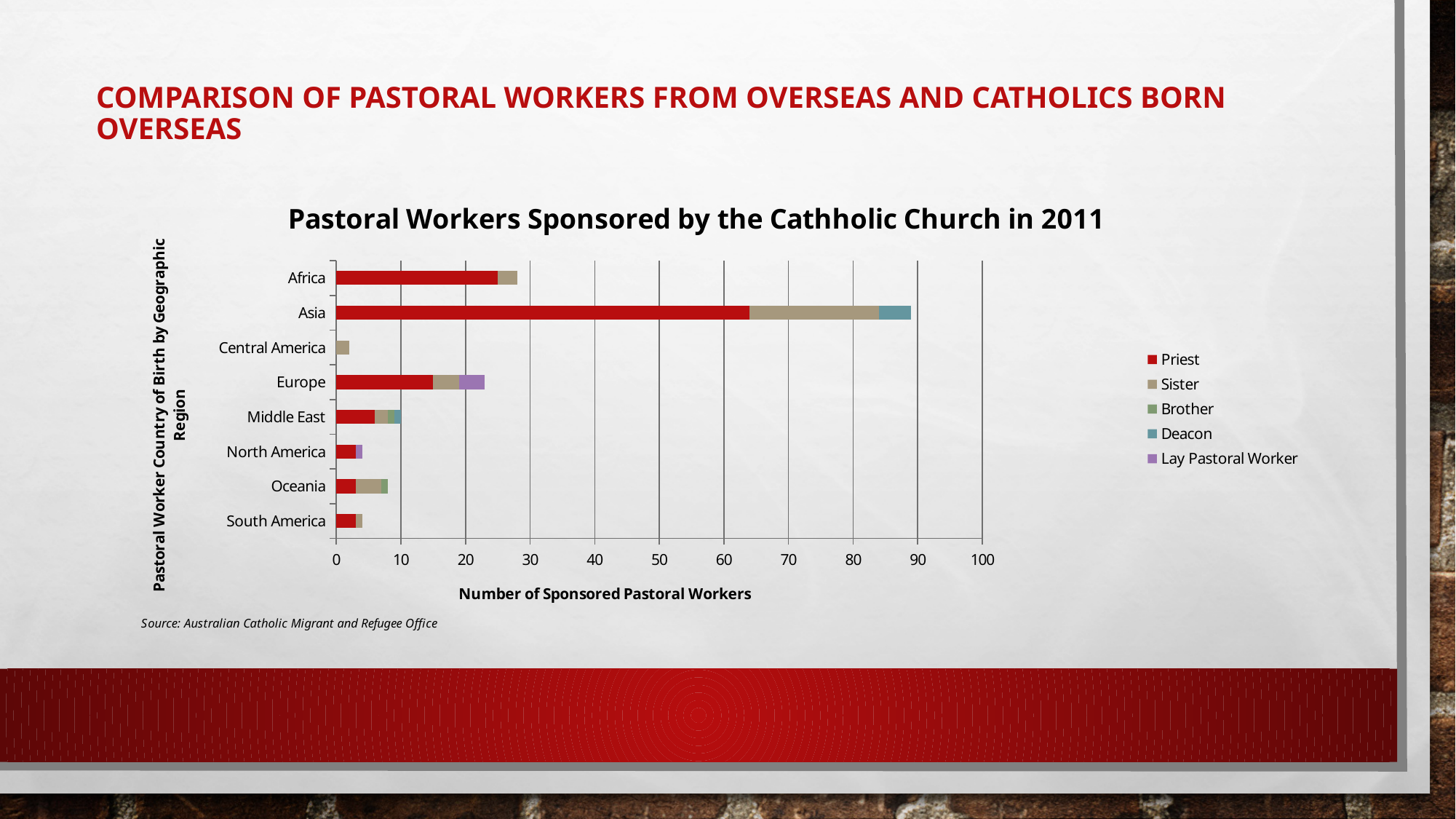
Is the total number of sponsored pastoral workers for Central America greater or less than 10? less Is the total number of sponsored pastoral workers for Europe greater or less than 20? greater What is the label of the x axis? Number of Sponsored Pastoral Workers What kind of chart is shown on the slide? Stacked bar chart Is the total number of sponsored pastoral workers for Asia greater or less than 80? greater Which region has the lowest total number of sponsored pastoral workers? Central America How many series does the legend list? 5 Which region has a larger total of sponsored pastoral workers, Africa or Europe? Africa What is the title of the chart? Pastoral Workers Sponsored by the Cathholic Church in 2011 Which region has the highest total number of sponsored pastoral workers? Asia How many geographic regions are shown on the y axis? 8